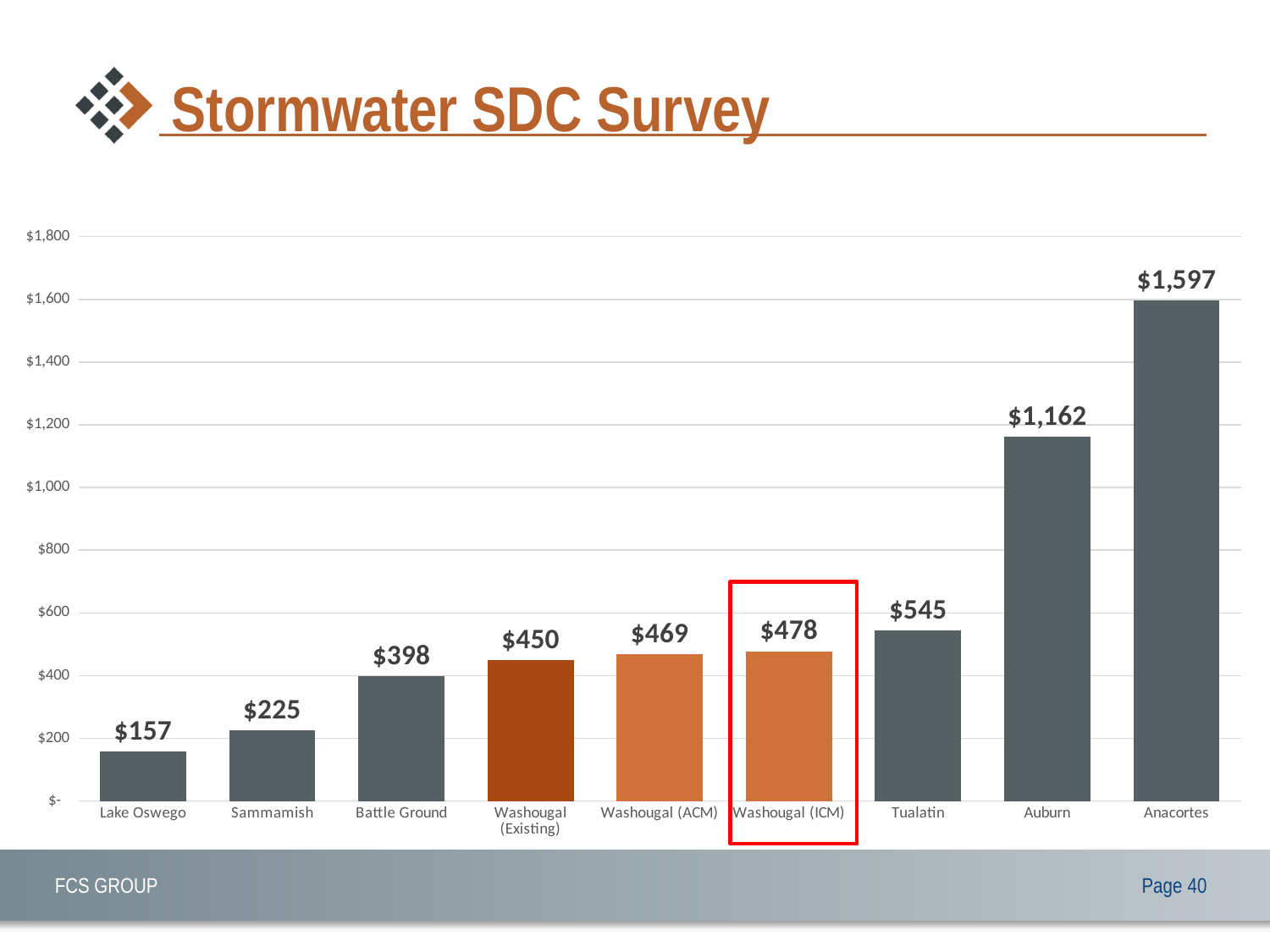
What is the value for Washougal (ICM)? $478 What is the value for Lake Oswego? $157 Which category's bar is outlined with a red box? Washougal (ICM) What is the difference between the values for Washougal (ICM) and Washougal (Existing)? $28 What is the difference between the values for Anacortes and Auburn? $435 Which category has the lowest value? Lake Oswego Is the value for Sammamish greater or less than $400? less Which is larger, the value for Tualatin or the value for Battle Ground? Tualatin Which category has the highest value? Anacortes How many categories are shown on the x axis? 9 What kind of chart is shown on the slide? bar chart What is the value for Auburn? $1,162